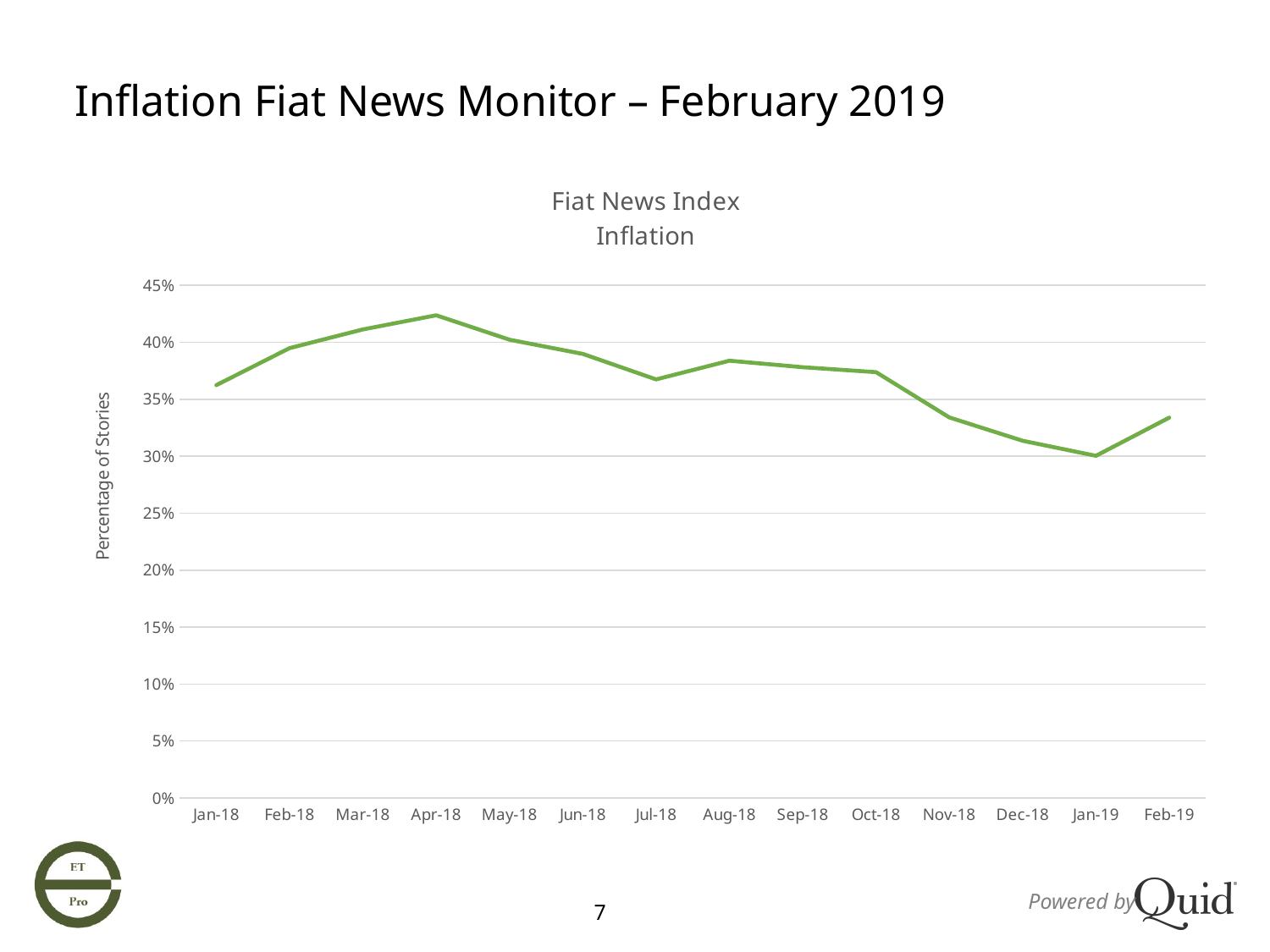
Is the value for Nov-18 greater or less than 35%? less Is the value for Apr-18 greater or less than 40%? greater Which month has the highest percentage of stories? Apr-18 How many months are plotted on the x axis? 14 Is the value for Jan-19 greater or less than 35%? less Which month has the lowest percentage of stories? Jan-19 Which is larger, the value for Mar-18 or the value for Nov-18? Mar-18 Which is larger, the value for Feb-18 or the value for Jul-18? Feb-18 What kind of chart is shown on the slide? line chart What is the label on the y axis? Percentage of Stories Do the values rise or fall from Apr-18 to Jan-19? fall